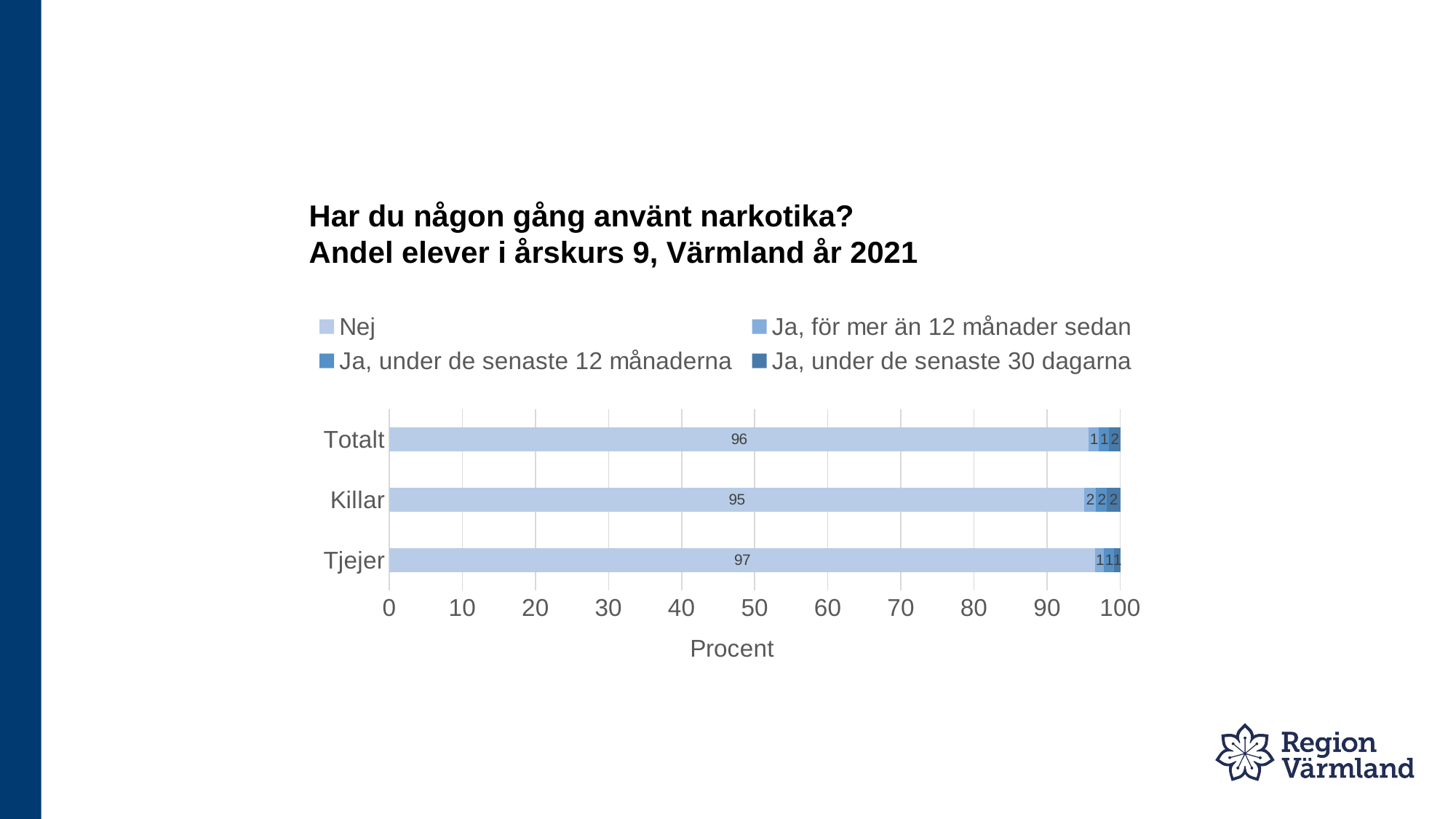
What is the value of 'Ja, under de senaste 30 dagarna' for Killar? 2 What kind of chart is shown on the slide? Stacked bar chart What is the difference between the 'Nej' values for Tjejer and Killar? 2 What is the value of 'Nej' for Totalt? 96 What is the label of the horizontal axis? Procent How many series does the legend list? 4 How many categories are shown on the vertical axis? 3 Which category has the highest value for 'Nej'? Tjejer What is the value of 'Nej' for Tjejer? 97 What is the value of 'Nej' for Killar? 95 Which category has the lowest value for 'Nej'? Killar Which is larger, the 'Nej' value for Totalt or for Killar? Totalt